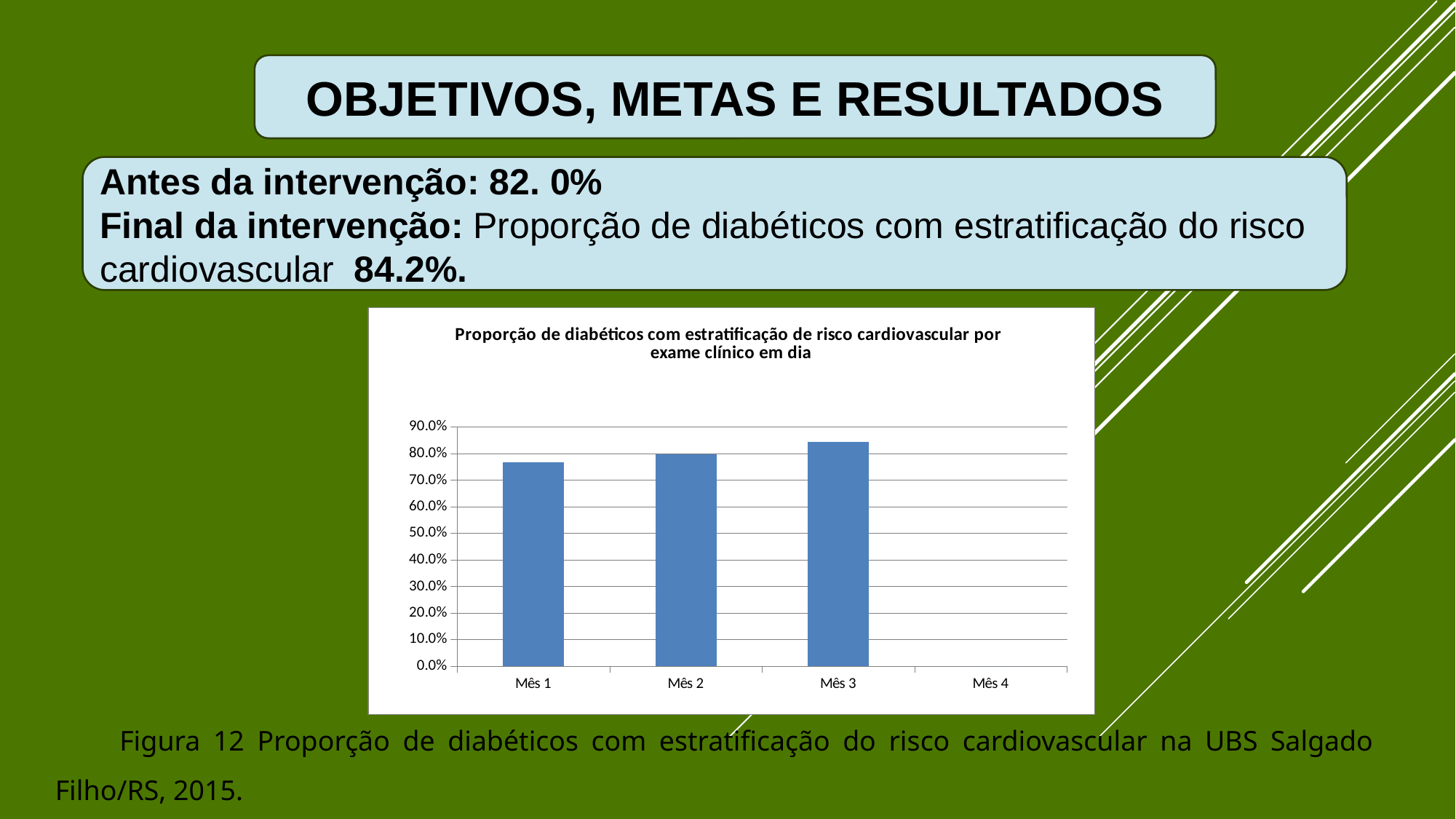
Is the value for Mês 3 greater or less than 90.0%? less Do the values rise or fall from Mês 1 to Mês 3? rise How many categories are shown on the x axis of the chart? 4 Is the value for Mês 1 greater or less than 80.0%? less What is the title of the chart? Proporção de diabéticos com estratificação de risco cardiovascular por exame clínico em dia Is the value for Mês 1 greater or less than 70.0%? greater What kind of chart is shown on the slide? bar chart How many bars are actually plotted in the chart? 3 Which month has the highest bar in the chart? Mês 3 What is the highest value shown on the y axis of the chart? 90.0% Which is larger, the value for Mês 1 or the value for Mês 3? Mês 3